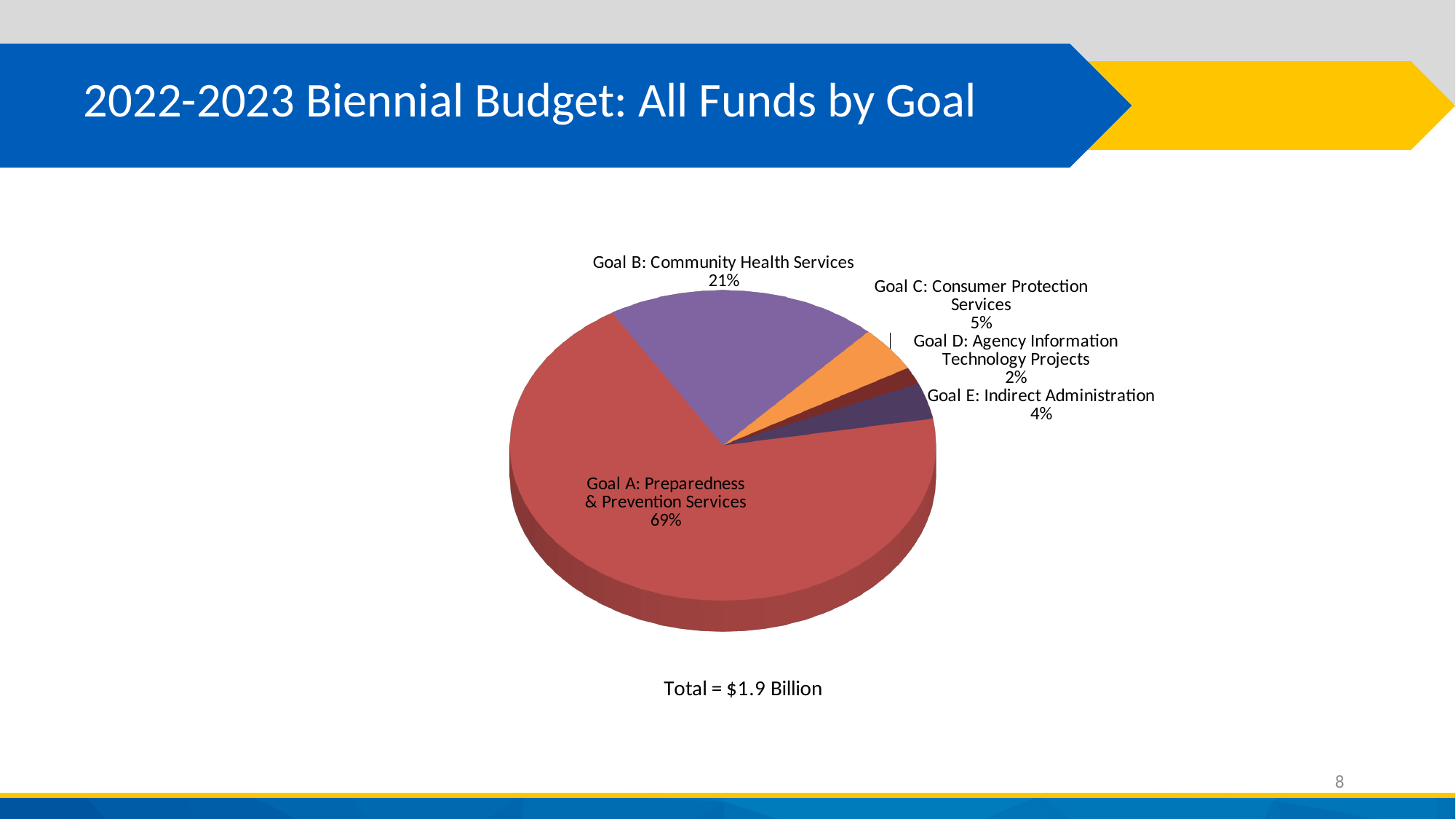
What kind of chart is shown on the slide? Pie chart What share of the budget goes to Goal E: Indirect Administration? 4% What total amount is stated below the chart? $1.9 Billion What share of the budget goes to Goal A: Preparedness & Prevention Services? 69% What share of the budget goes to Goal D: Agency Information Technology Projects? 2% What is the difference in percentage points between Goal A and Goal B? 48 How many goals are shown in the pie chart? 5 Which goal has the largest share of the budget? Goal A: Preparedness & Prevention Services Which has a larger share, Goal C: Consumer Protection Services or Goal E: Indirect Administration? Goal C: Consumer Protection Services Which goal has the smallest share of the budget? Goal D: Agency Information Technology Projects